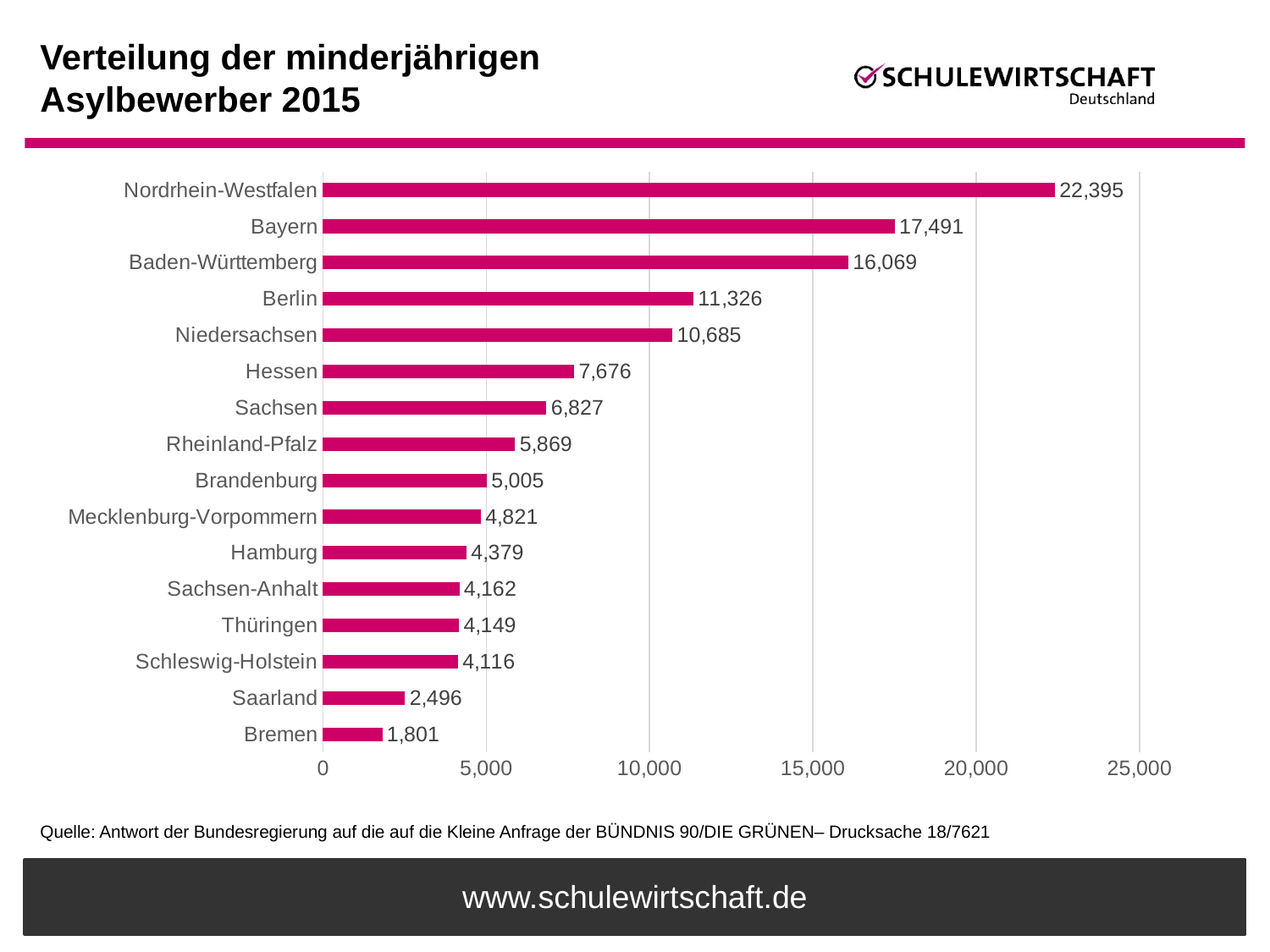
What is the value for Hessen? 7,676 What is the difference between the values for Berlin and Niedersachsen? 641 What is the title of the chart? Verteilung der minderjährigen Asylbewerber 2015 What is the value for Mecklenburg-Vorpommern? 4,821 What kind of chart is shown on the slide? bar chart Which is larger, the value for Sachsen or the value for Rheinland-Pfalz? Sachsen What is the difference between the values for Nordrhein-Westfalen and Bayern? 4,904 Which category has the lowest value? Bremen Is the value for Baden-Württemberg greater or less than 15,000? greater Which category has the highest value? Nordrhein-Westfalen What is the value for Bayern? 17,491 How many categories are shown in the chart? 16